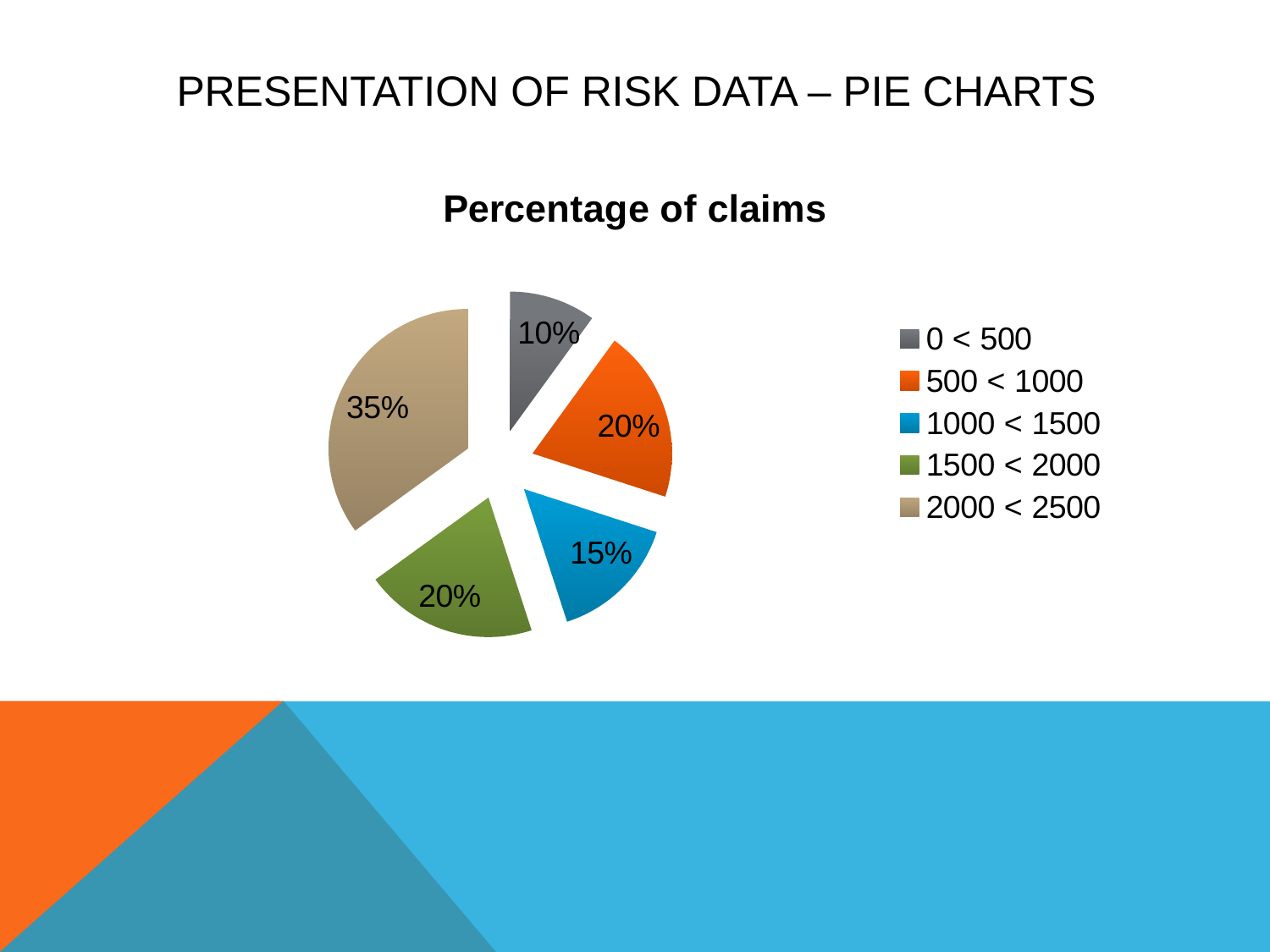
Which category has the largest share of claims? 2000 < 2500 What percentage of claims falls in the 0 < 500 category? 10% What colour is the slice for the 1000 < 1500 category? blue Which is larger, the share for 1500 < 2000 or the share for 1000 < 1500? 1500 < 2000 What type of chart is shown on the slide? pie chart What is the title of the chart? Percentage of claims What percentage of claims falls in the 2000 < 2500 category? 35% What is the difference in percentage points between the 2000 < 2500 slice and the 1000 < 1500 slice? 20 How many categories does the pie chart show? 5 Which category has the smallest share of claims? 0 < 500 What percentage of claims falls in the 1000 < 1500 category? 15% What percentage of claims falls in the 500 < 1000 category? 20%